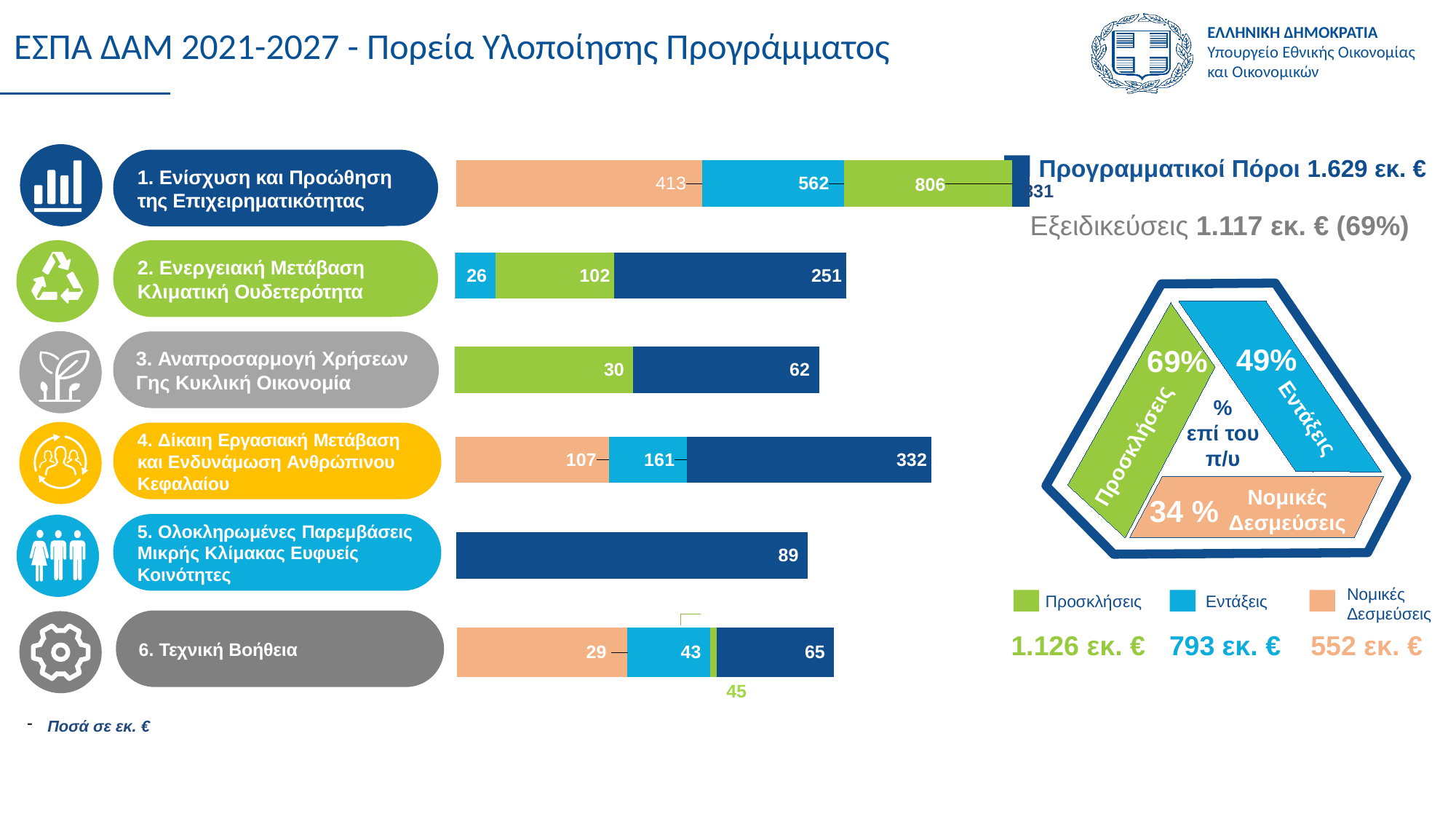
How many priorities (categories) are shown in the bar chart? 6 Which priority has the largest dark blue bar value? 1. Ενίσχυση και Προώθηση της Επιχειρηματικότητας What is the Εντάξεις (light blue) value for priority 4, Δίκαιη Εργασιακή Μετάβαση και Ενδυνάμωση Ανθρώπινου Κεφαλαίου? 161 What is the Προσκλήσεις (green) value for priority 2, Ενεργειακή Μετάβαση Κλιματική Ουδετερότητα? 102 What kind of chart is used to show the programme implementation by priority? Bar chart What value is printed on the dark blue bar for priority 5, Ολοκληρωμένες Παρεμβάσεις Μικρής Κλίμακας Ευφυείς Κοινότητες? 89 Which has the larger Προσκλήσεις (green) value: priority 2, Ενεργειακή Μετάβαση Κλιματική Ουδετερότητα, or priority 3, Αναπροσαρμογή Χρήσεων Γης Κυκλική Οικονομία? 2. Ενεργειακή Μετάβαση Κλιματική Ουδετερότητα What is the Νομικές Δεσμεύσεις (peach) value for priority 6, Τεχνική Βοήθεια? 29 Which priority has the smallest dark blue bar value? 3. Αναπροσαρμογή Χρήσεων Γης Κυκλική Οικονομία For priority 1, Ενίσχυση και Προώθηση της Επιχειρηματικότητας, what is the difference between the Προσκλήσεις value (806) and the Εντάξεις value (562)? 244 For priority 4, what is the difference between the dark blue value (332) and the Εντάξεις value (161)? 171 How many series does the legend list? 3